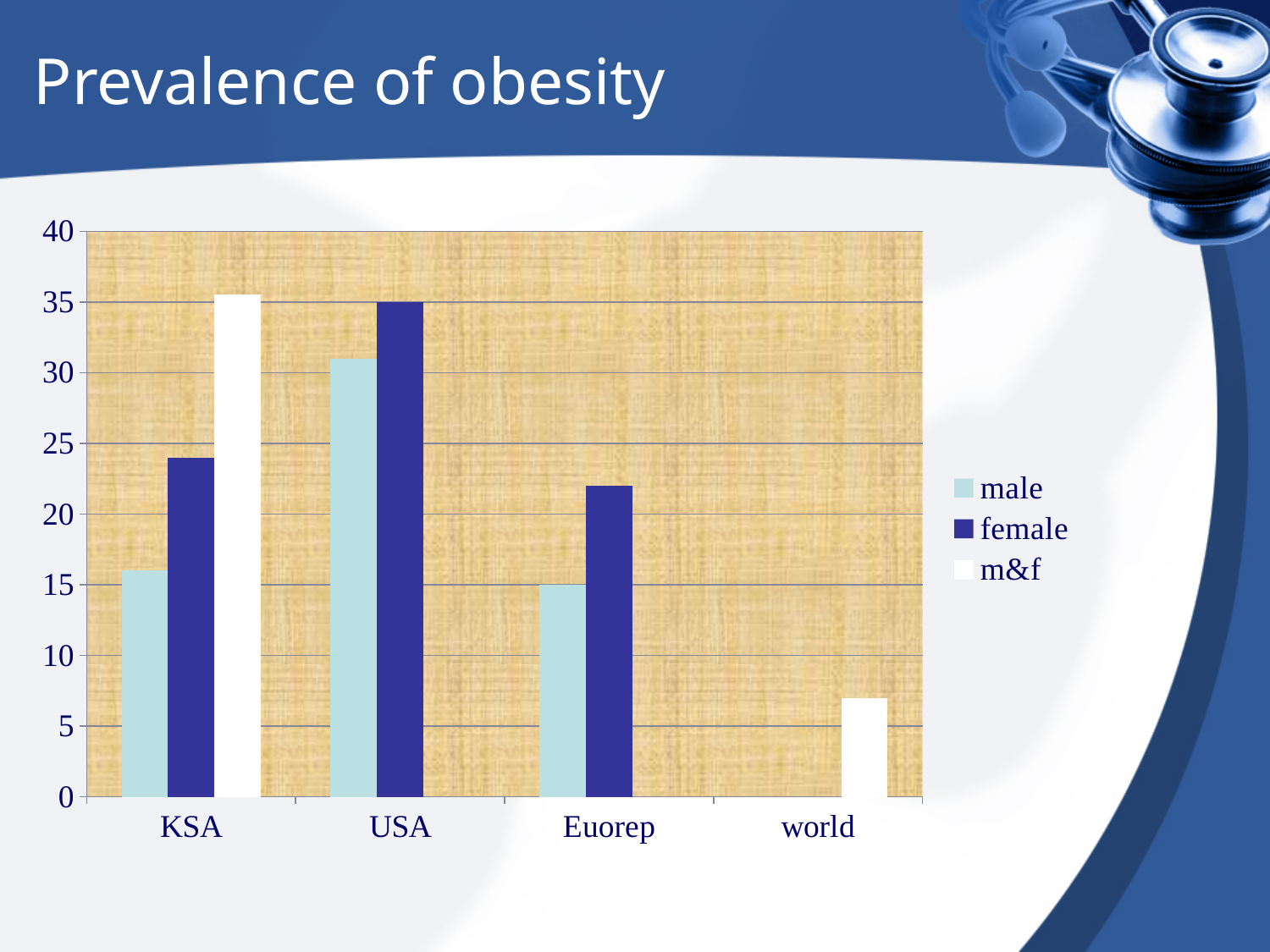
How many series does the legend list? 3 What kind of chart is shown on the slide? bar chart What is the title of the slide containing the chart? Prevalence of obesity Which is larger, the female value for KSA or the female value for USA? USA What is the male value for Euorep? 15 Is the m&f value for KSA greater or less than 30? greater Which series is shown in white in the legend? m&f Is the m&f value for world greater or less than 10? less How many categories are shown on the x axis? 4 Which category has the highest male value? USA Is the male value for KSA greater or less than 20? less What is the female value for USA? 35